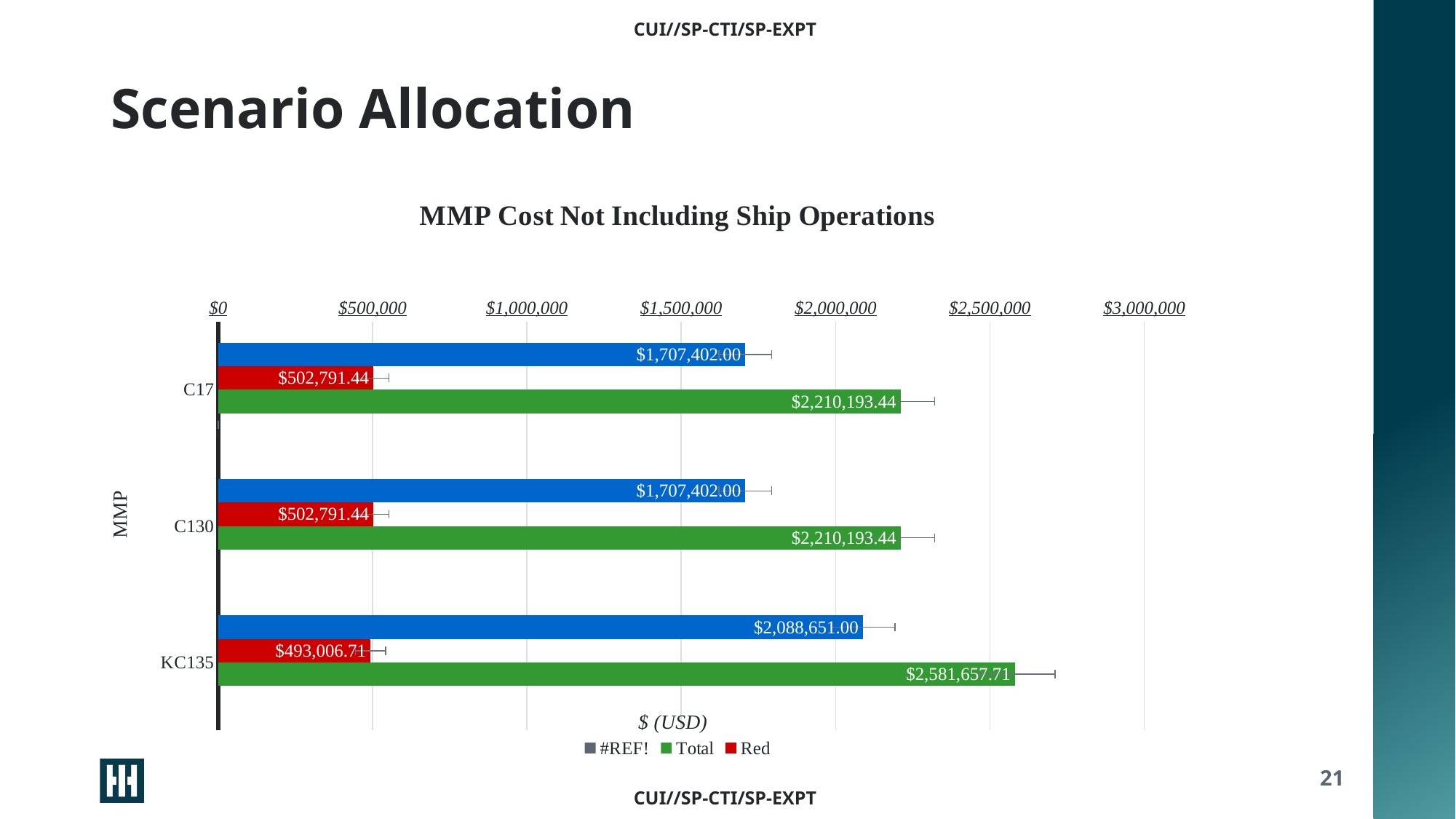
What is the difference between the Red value for C17 and the Red value for KC135? $9,784.73 How many categories are shown on the y axis? 3 How much larger is the Total value for KC135 than the Total value for C17? $371,464.27 What is the Red value for C17? $502,791.44 Is the Total value for C17 greater or less than $2,000,000? greater Which category has the highest Total value? KC135 How many series does the legend list? 3 For C130, which is larger: the Total value or the blue bar value? Total What is the Total value for KC135? $2,581,657.71 What is the value of the blue bar for KC135? $2,088,651.00 Which category has the lowest Red value? KC135 What kind of chart is shown on the slide? bar chart